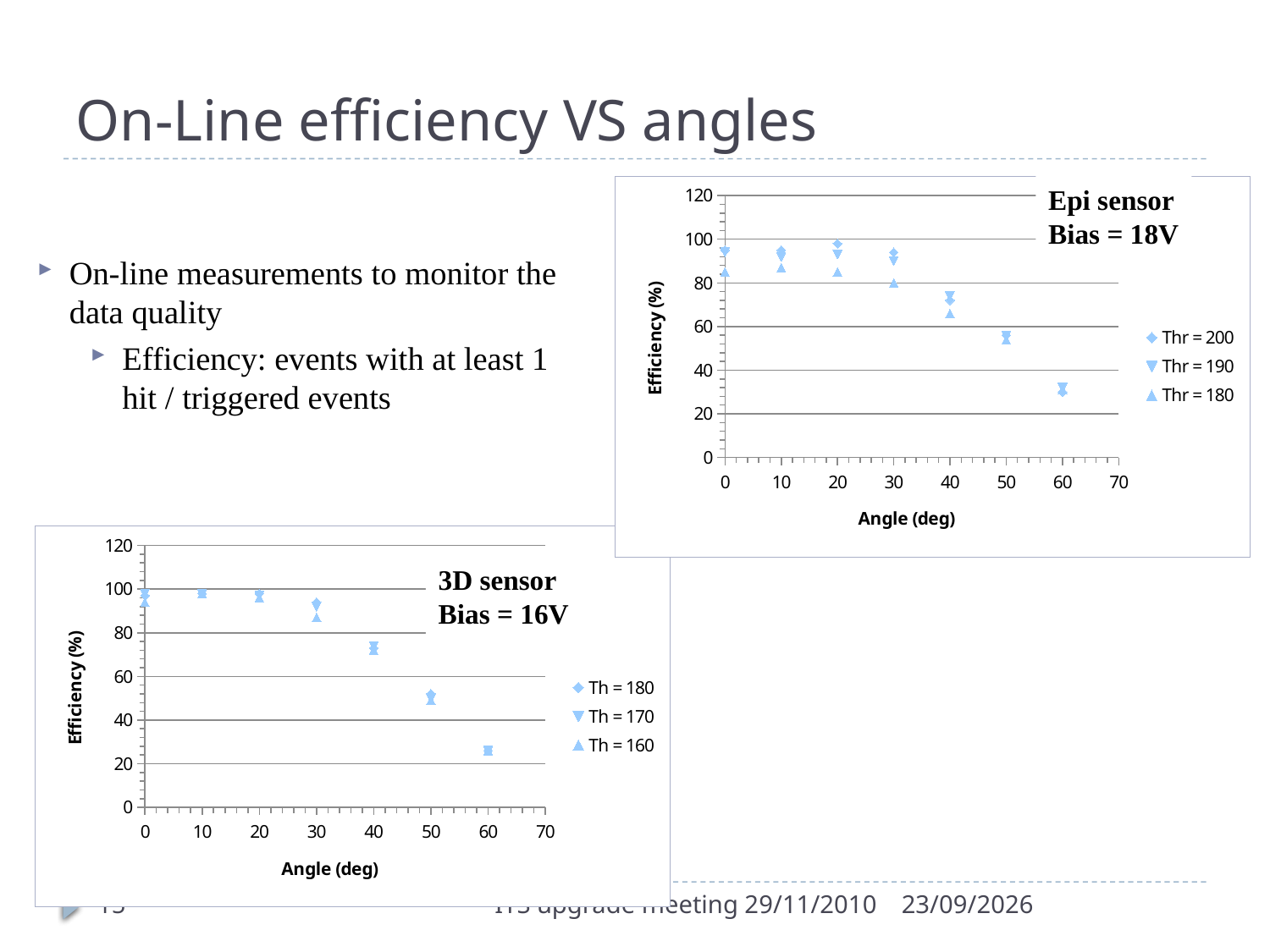
How many series does the legend of the 3D sensor chart list? 3 How many angle values are plotted for each series in the Epi sensor chart? 7 In the 3D sensor chart, is the efficiency at 60 degrees greater or less than 40? less What kind of chart is the Epi sensor chart? scatter chart In the Epi sensor chart, is the efficiency at 50 degrees greater or less than 60? less In the Epi sensor chart, is the efficiency for Thr = 180 at 40 degrees greater or less than 60? greater What is the x-axis label of the 3D sensor chart? Angle (deg) In the 3D sensor chart, does efficiency rise or fall as the angle increases from 30 to 60 degrees? fall How many series does the legend of the Epi sensor chart list? 3